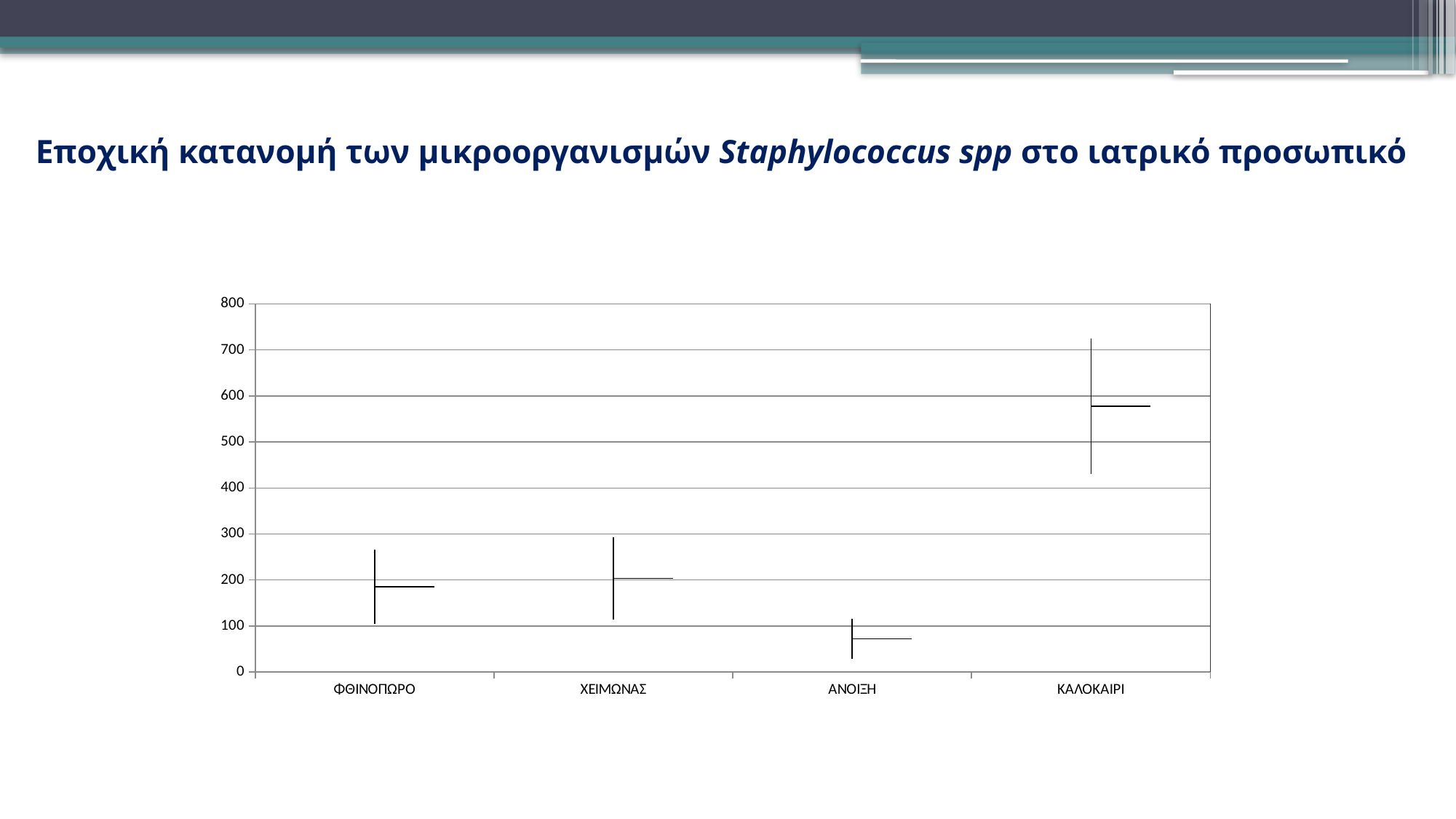
Which has a larger horizontal marker value, ΦΘΙΝΟΠΩΡΟ or ΑΝΟΙΞΗ? ΦΘΙΝΟΠΩΡΟ Is the horizontal marker value for ΚΑΛΟΚΑΙΡΙ greater or less than 500? greater Is the top of the vertical line for ΚΑΛΟΚΑΙΡΙ greater or less than 700? greater Which microorganism is named in the slide title? Staphylococcus spp How many categories are shown on the x axis of the chart? 4 Is the horizontal marker value for ΑΝΟΙΞΗ greater or less than 100? less Which has a larger horizontal marker value, ΚΑΛΟΚΑΙΡΙ or ΧΕΙΜΩΝΑΣ? ΚΑΛΟΚΑΙΡΙ What is the maximum value shown on the vertical axis of the chart? 800 Which category has the lowest values on the chart? ΑΝΟΙΞΗ Which category has the highest values on the chart? ΚΑΛΟΚΑΙΡΙ